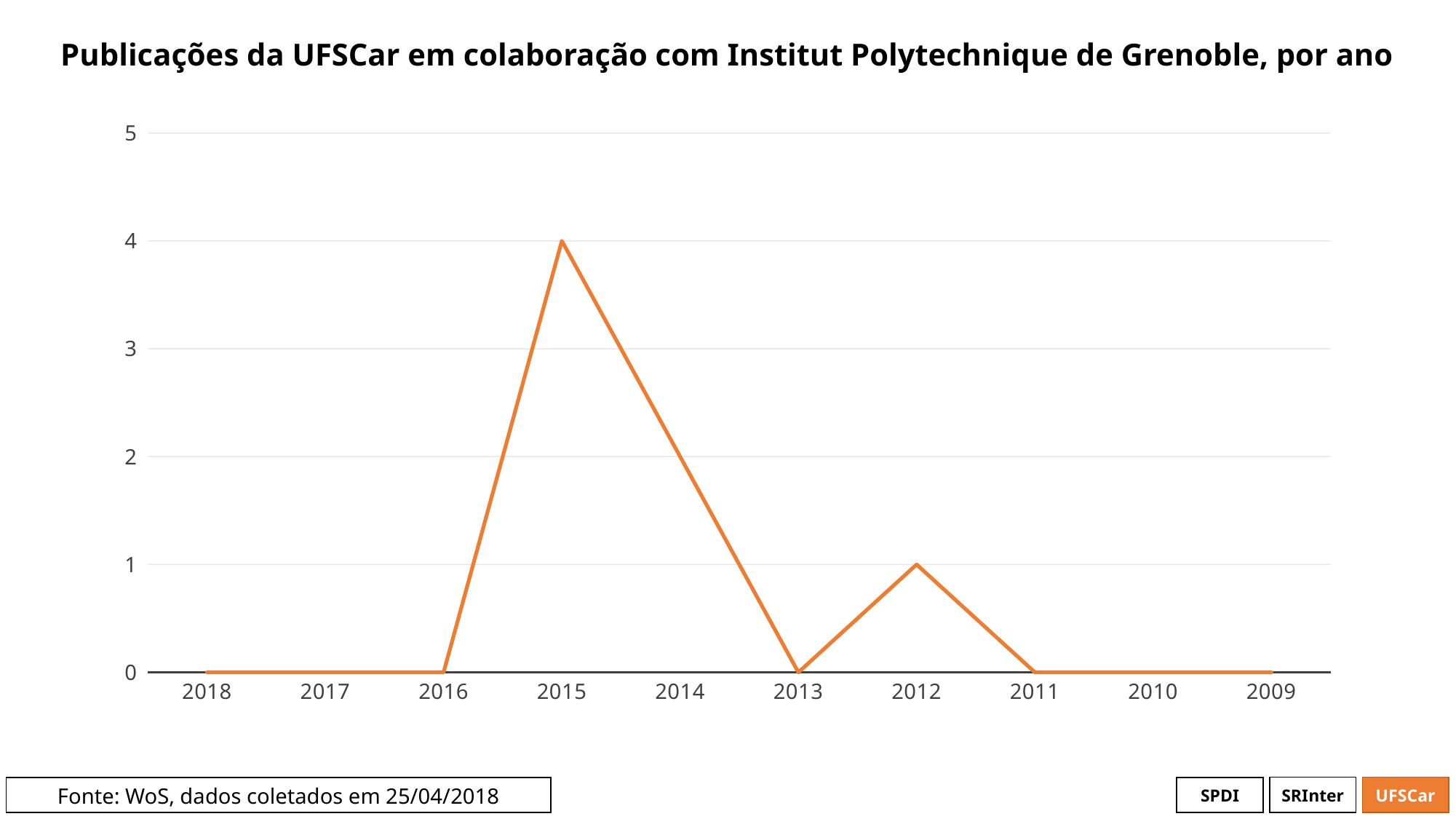
What type of chart is shown on the slide? line chart What is the title of the chart? Publicações da UFSCar em colaboração com Institut Polytechnique de Grenoble, por ano What is the difference between the values for 2015 and 2012? 3 What is the value for 2014? 2 How many years are shown on the x axis? 10 Do the values rise or fall from 2015 to 2013? fall What is the value for 2017? 0 Which year has the highest value? 2015 Which is larger, the value for 2014 or the value for 2012? 2014 Is the value for 2015 greater or less than 3? greater What is the value for 2012? 1 What is the value for 2015? 4